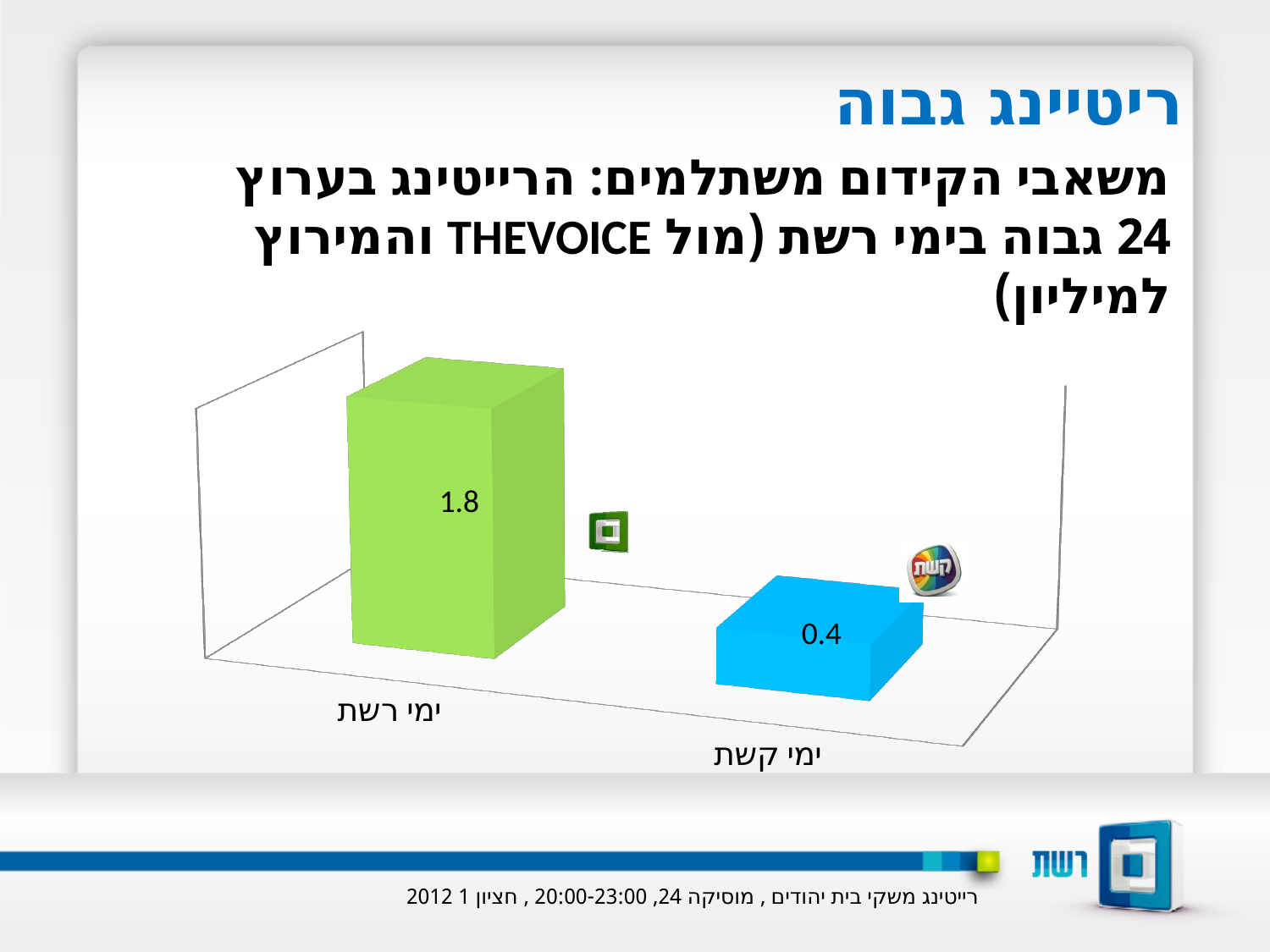
What is the value shown for ימי רשת? 1.8 What colour is the bar for ימי קשת? blue What is the difference between the values for ימי רשת and ימי קשת? 1.4 What colour is the bar for ימי רשת? green What is the value shown for ימי קשת? 0.4 Which is larger, the value for ימי רשת or the value for ימי קשת? ימי רשת Which category has the highest value? ימי רשת What kind of chart is shown on the slide? bar chart How many categories are plotted in the chart? 2 Which category has the lowest value? ימי קשת